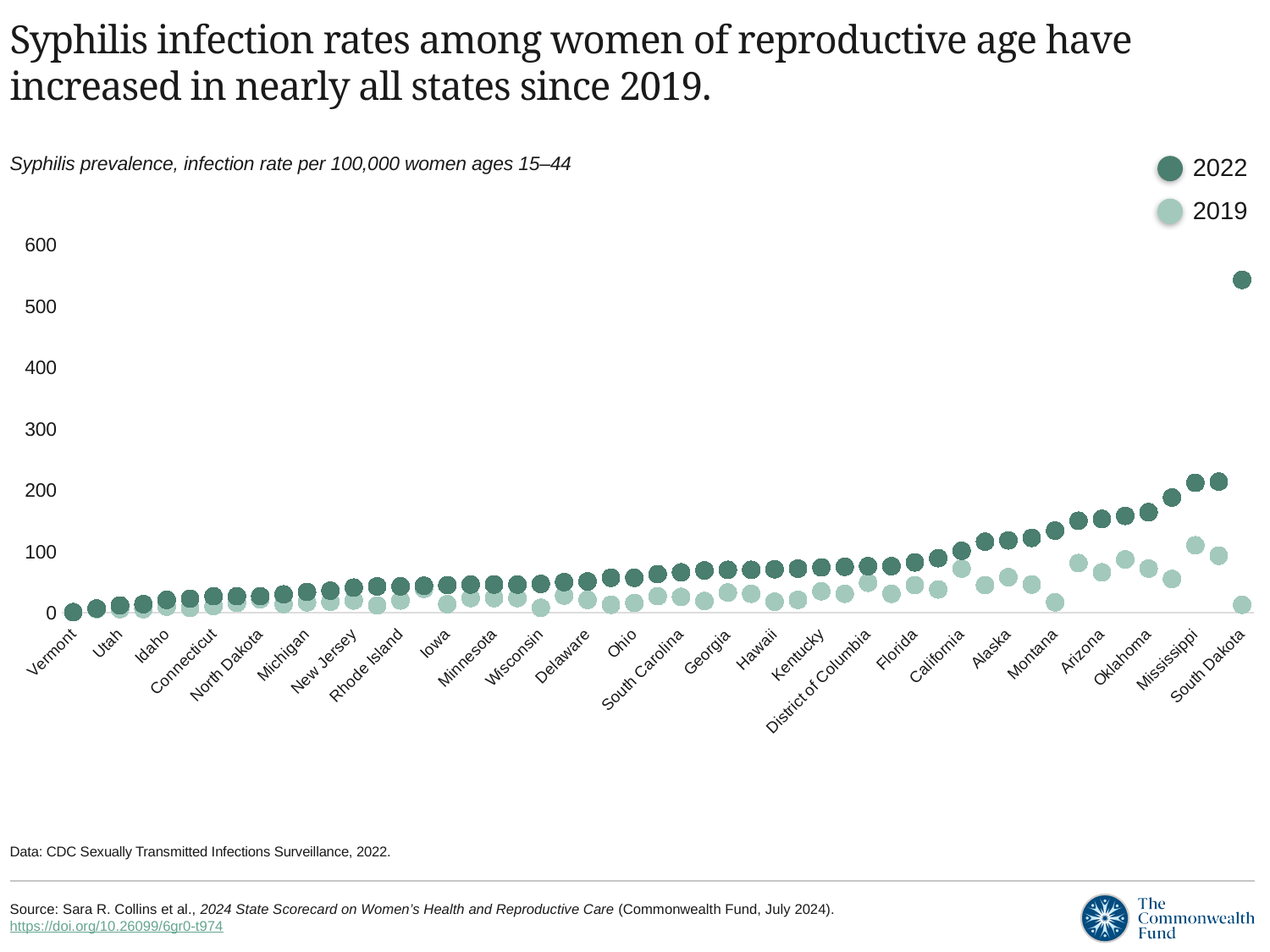
Which state has the lowest 2022 syphilis infection rate? Vermont Which state has the highest 2022 syphilis infection rate? South Dakota What measure does the chart subtitle say is plotted? Syphilis prevalence, infection rate per 100,000 women ages 15–44 How many series does the legend list? 2 Which two years are shown in the legend? 2022 and 2019 For South Dakota, which is larger: the 2022 value or the 2019 value? 2022 Is the 2022 value for Vermont greater or less than 100? less Do the 2022 values rise or fall moving from left to right along the x axis? rise Is the 2022 value for Mississippi greater or less than 100? greater What kind of chart is shown on the slide? Dot plot (scatter chart) Is the 2019 value for South Dakota greater or less than 100? less